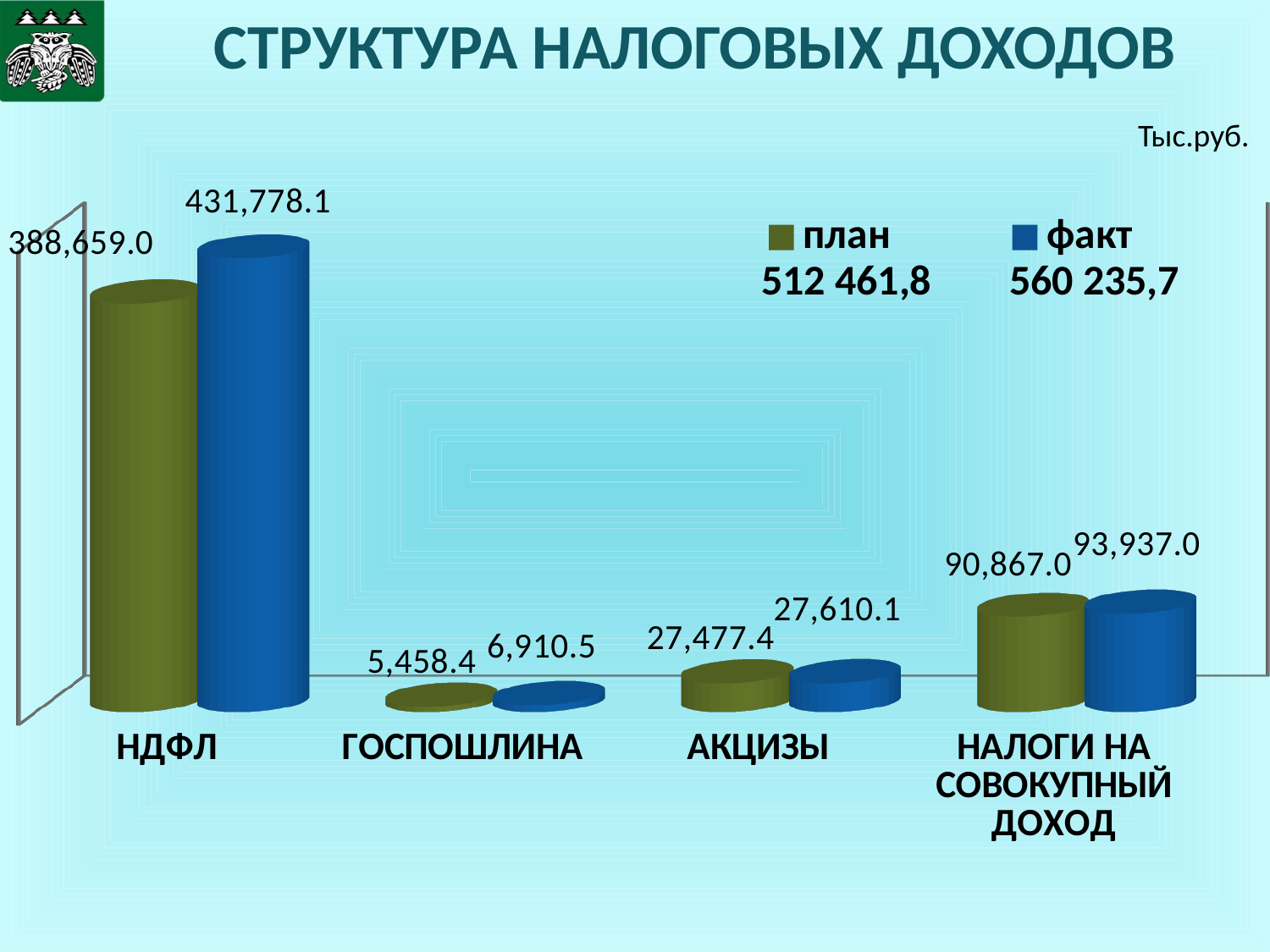
Which category has the lowest план value? ГОСПОШЛИНА What is the факт value for АКЦИЗЫ? 27,610.1 What is the план value for НДФЛ? 388,659.0 What is the факт value for НДФЛ? 431,778.1 What is the difference between the факт and план values for НДФЛ? 43,119.1 For НАЛОГИ НА СОВОКУПНЫЙ ДОХОД, which is larger, план or факт? факт How many series does the legend list? 2 How many categories are shown on the x axis? 4 What type of chart is shown on the slide? bar chart What is the факт value for НАЛОГИ НА СОВОКУПНЫЙ ДОХОД? 93,937.0 Which category has the highest факт value? НДФЛ What is the план value for ГОСПОШЛИНА? 5,458.4